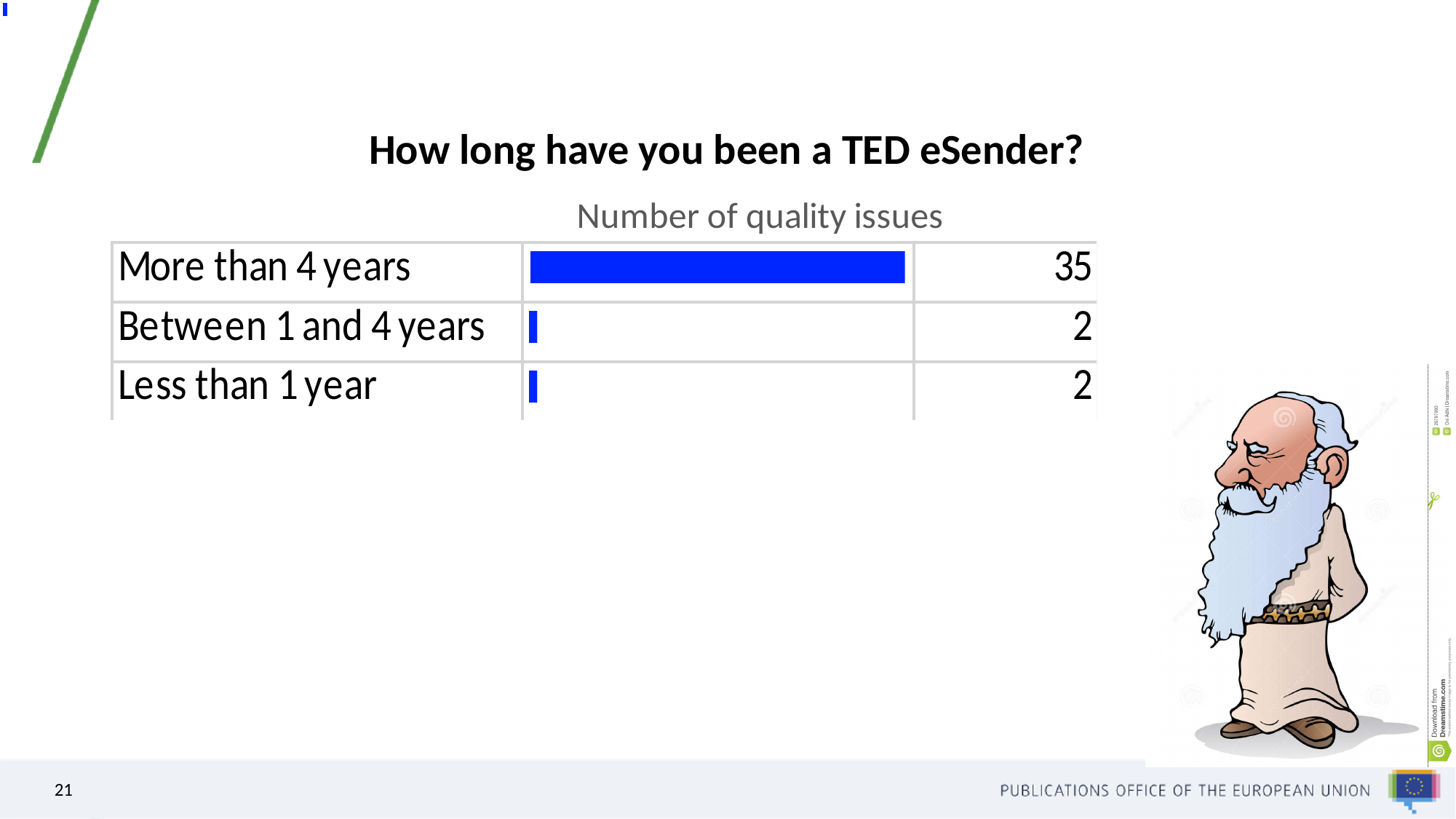
Do 'Between 1 and 4 years' and 'Less than 1 year' have the same number of quality issues? Yes What is the total number of quality issues across all three categories? 39 Which has more quality issues, 'More than 4 years' or 'Less than 1 year'? More than 4 years What is the number of quality issues for 'Less than 1 year'? 2 Which category has the highest number of quality issues? More than 4 years What kind of chart is shown on the slide? Bar chart What is the title of the chart? Number of quality issues What is the number of quality issues for 'Between 1 and 4 years'? 2 What colour are the bars in the chart? Blue What is the difference in quality issues between 'More than 4 years' and 'Between 1 and 4 years'? 33 How many categories are shown in the chart? 3 What is the number of quality issues for 'More than 4 years'? 35